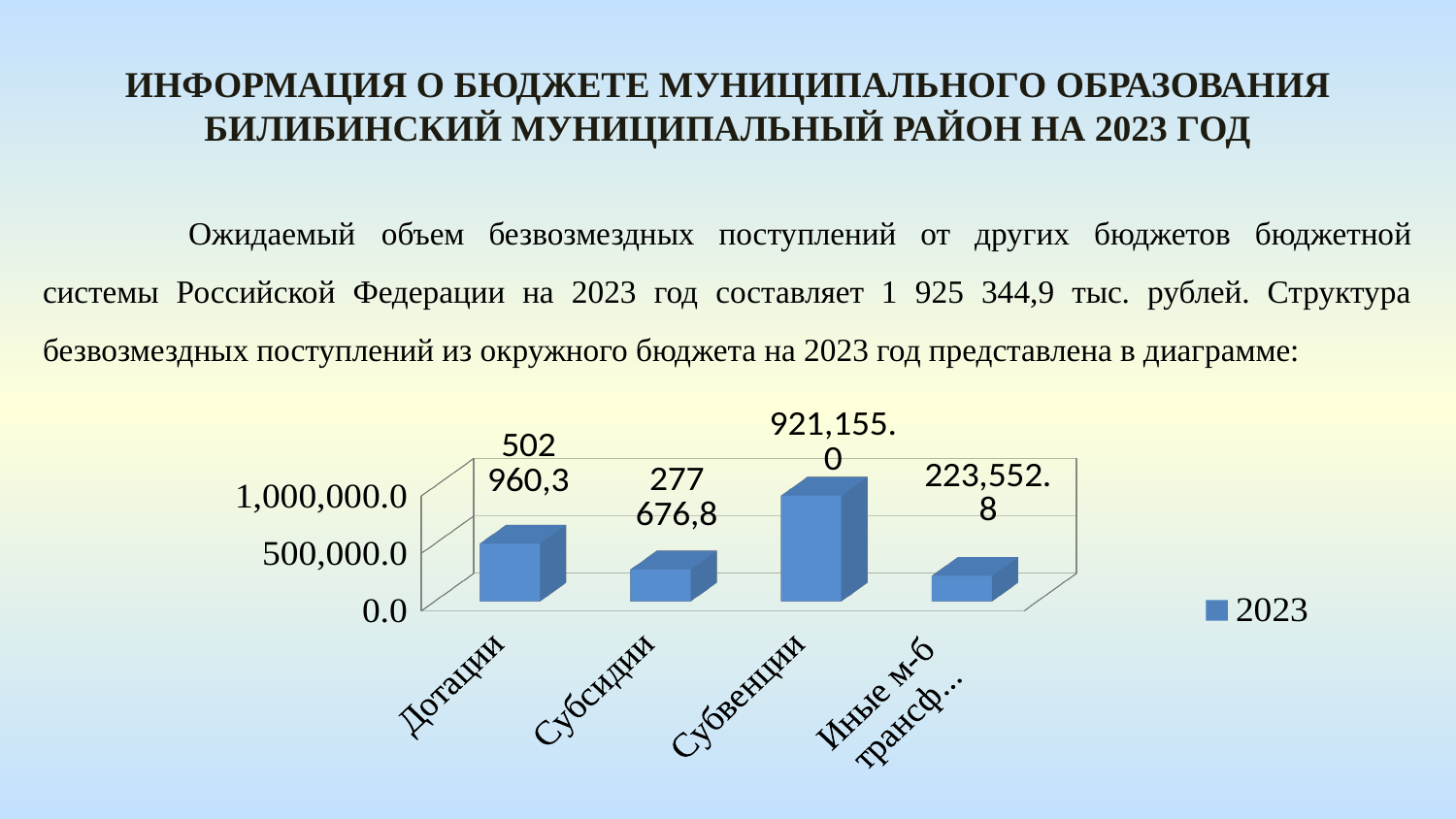
Which category has the highest value? Субвенции What is the value for Дотации? 502 960,3 Which category has the lowest value? Иные м-б трансф... What is the value for Субсидии? 277 676,8 What is the value for Субвенции? 921,155.0 What series does the legend list? 2023 Is the value for Субвенции greater or less than 500,000.0? greater What is the difference between the values for Дотации and Субсидии? 225 283,5 What is the value for the category labelled Иные м-б трансф...? 223,552.8 Which is larger, the value for Дотации or the value for Субсидии? Дотации How many categories are shown on the chart? 4 What is the difference between the values for Субвенции and Иные м-б трансф...? 697,602.2